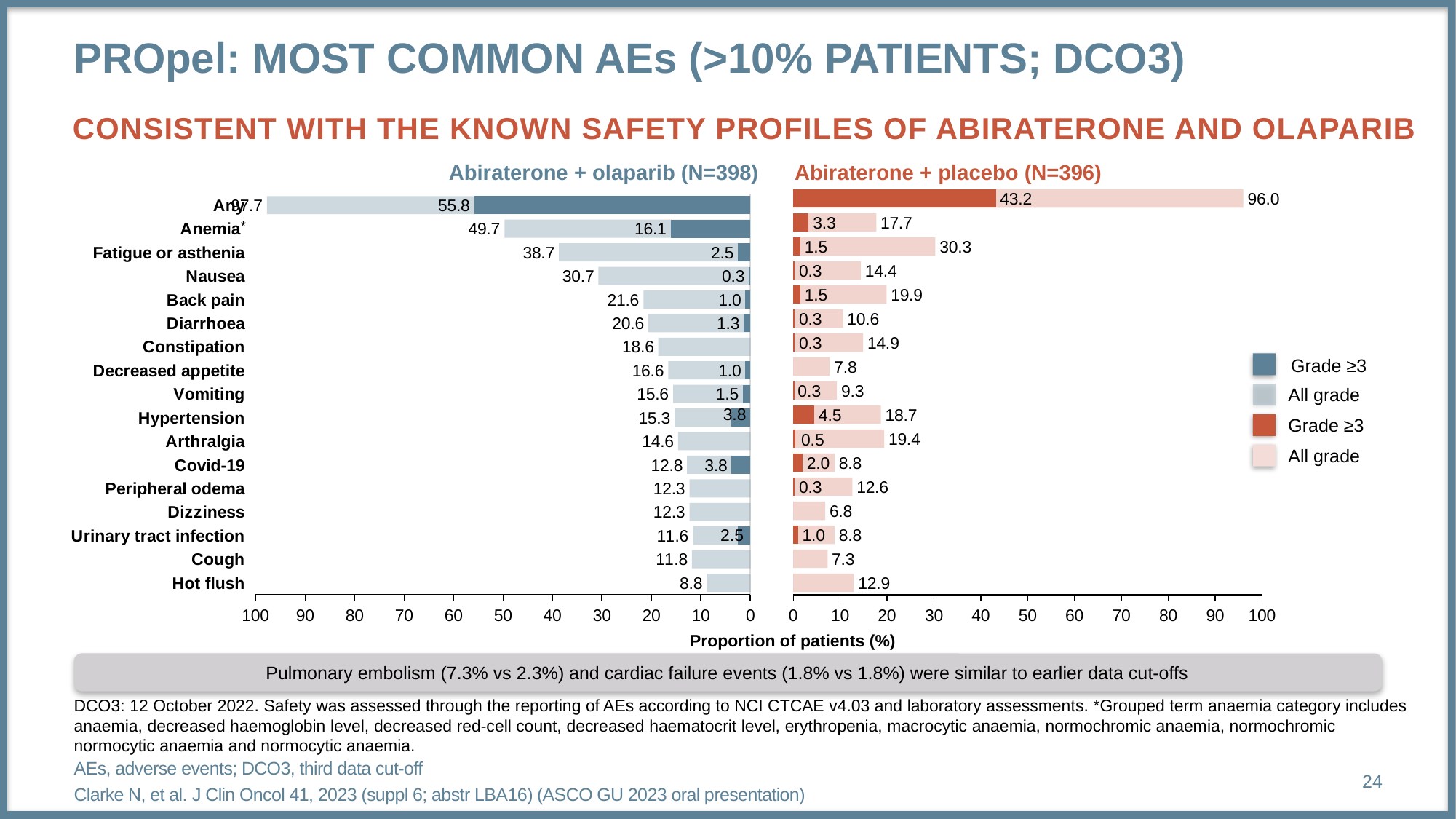
In the Abiraterone + olaparib (N=398) chart, what is the Grade ≥3 value for Anemia? 16.1 What is the difference between the all-grade Nausea values in the Abiraterone + olaparib chart (30.7) and the Abiraterone + placebo chart (14.4)? 16.3 Is the all-grade value for Back pain larger in the Abiraterone + olaparib chart or the Abiraterone + placebo chart? Abiraterone + olaparib What type of chart is used on this slide? Bar chart In the Abiraterone + olaparib (N=398) chart, which adverse event (excluding Any) has the highest all-grade value? Anemia In the Abiraterone + olaparib (N=398) chart, what is the all-grade value for Anemia? 49.7 How many adverse event categories are listed on the y axis of the charts? 17 How many entries does the legend list? 4 In the Abiraterone + placebo (N=396) chart, what is the Grade ≥3 value for Hypertension? 4.5 In the Abiraterone + olaparib (N=398) chart, which adverse event has the lowest all-grade value? Hot flush In the Abiraterone + placebo (N=396) chart, what is the all-grade value for Fatigue or asthenia? 30.3 In the Abiraterone + placebo (N=396) chart, which adverse event has the lowest all-grade value? Dizziness